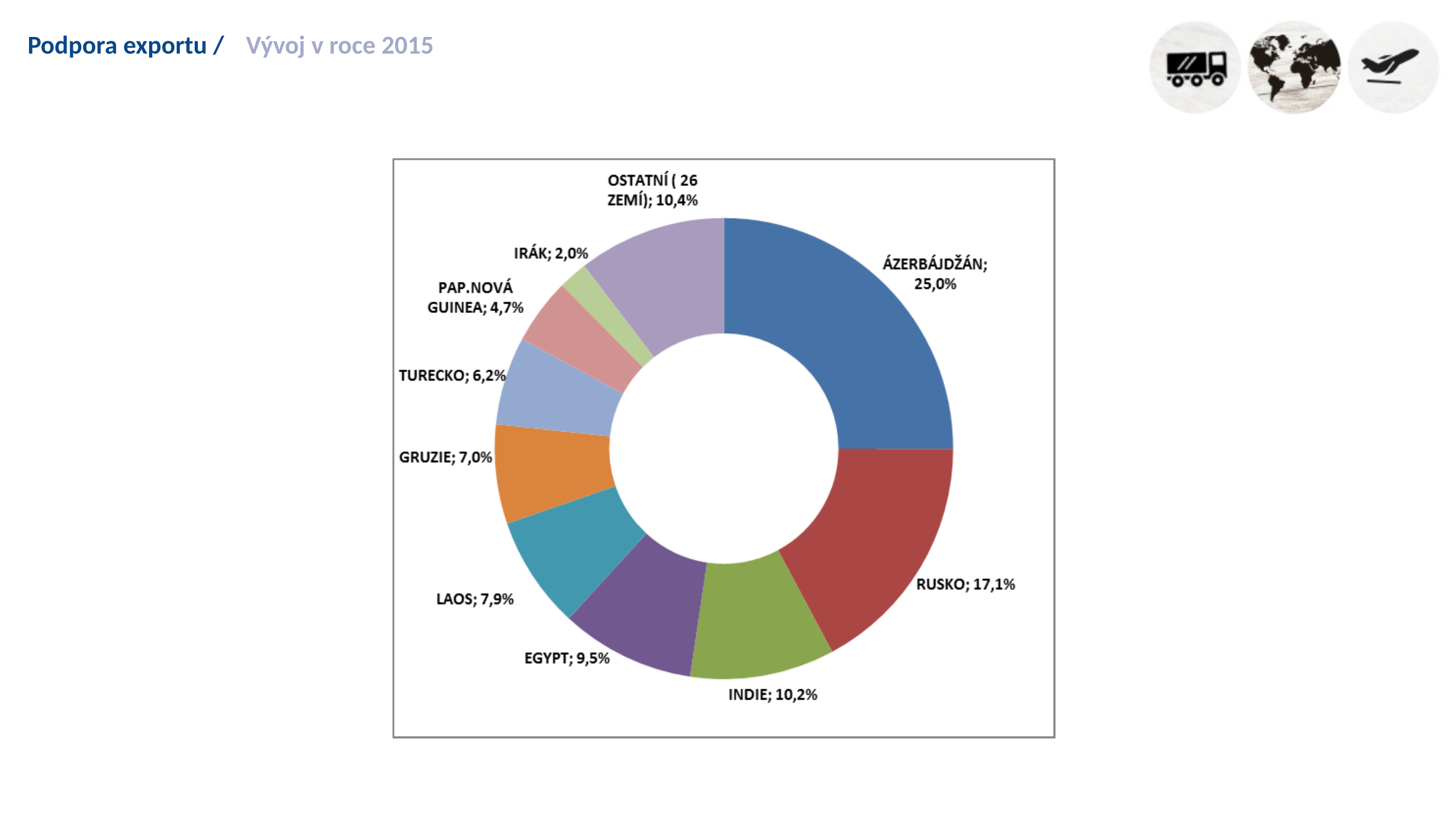
What share of the chart does ÁZERBÁJDŽÁN hold? 25,0% Which has a larger share, LAOS or GRUZIE? LAOS What percentage is shown for TURECKO? 6,2% Which country has the largest slice in the chart? ÁZERBÁJDŽÁN Which slice in the chart is the smallest? IRÁK Which has a larger share, INDIE or EGYPT? INDIE What share is labelled for OSTATNÍ (26 ZEMÍ)? 10,4% What kind of chart is shown on the slide? Doughnut (pie) chart What is the combined share of PAP.NOVÁ GUINEA and IRÁK? 6,7% How many slices does the chart have? 10 What is the value shown for RUSKO? 17,1% What is the difference in percentage points between ÁZERBÁJDŽÁN and RUSKO? 7,9